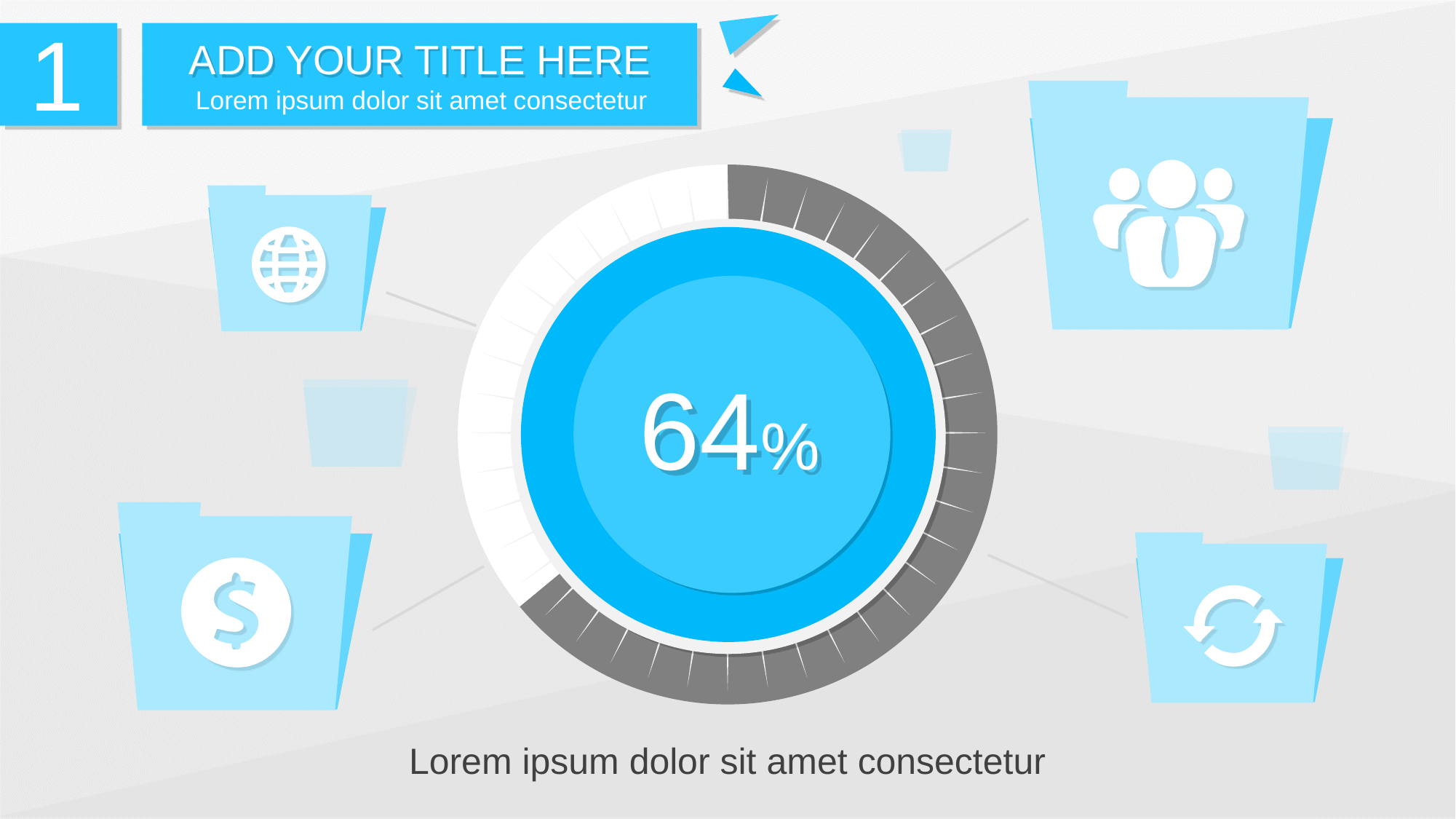
Which segment of the donut ring is larger, the gray one or the white one? gray What percentage value is displayed in the centre of the donut chart? 64% Is the value shown in the donut chart greater or less than 50%? greater What is the title text shown in the blue banner at the top of the slide? ADD YOUR TITLE HERE How many segments does the donut ring have? 2 If the gray segment represents 64%, what share does the white segment represent? 36% What colour is the larger segment of the donut ring? gray What kind of chart is shown in the centre of the slide? donut chart